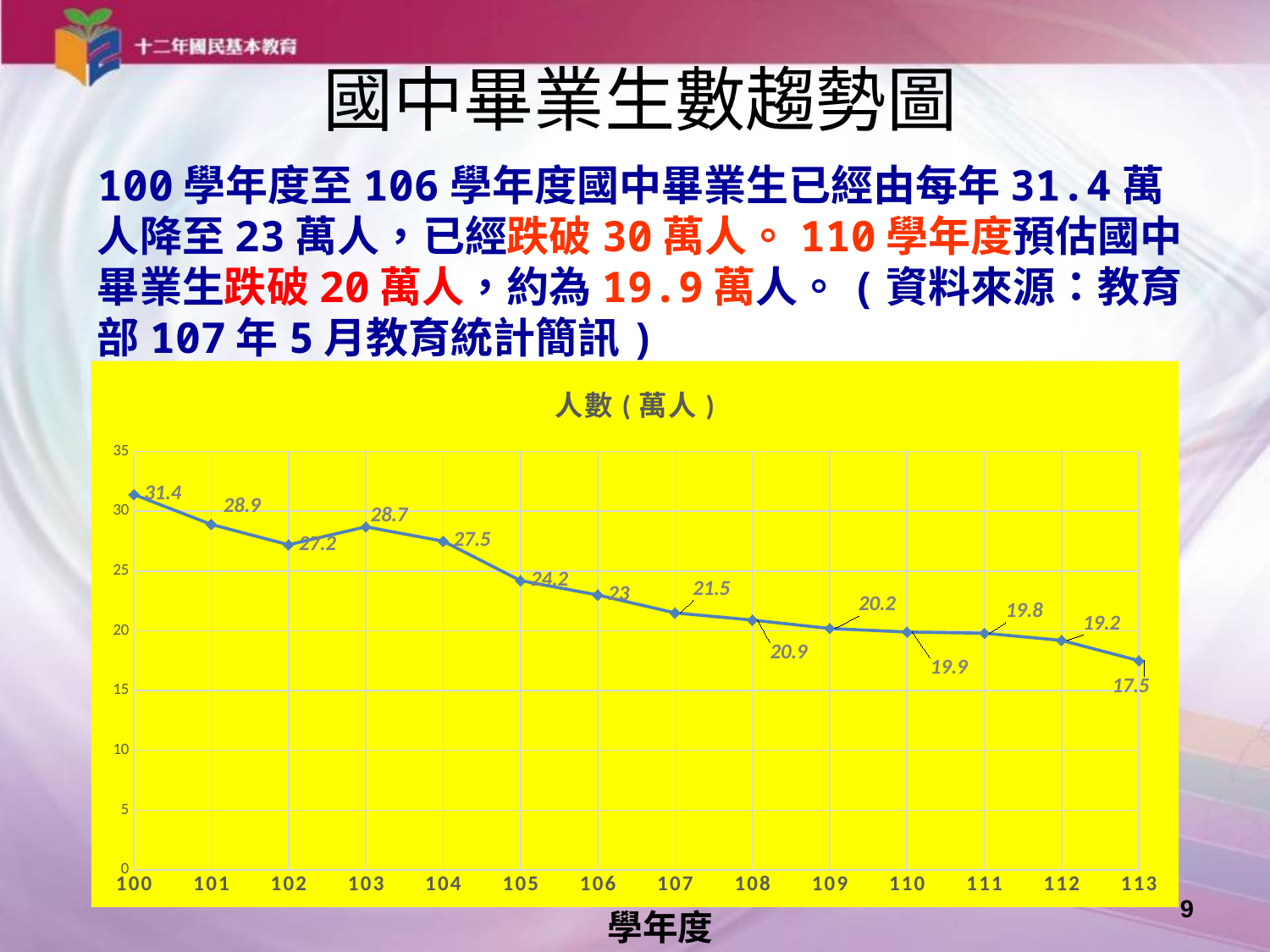
How many data points are plotted on the chart? 14 Which academic year has the highest value? 100 Which is larger, the value for academic year 102 or academic year 103? 103 Do the values generally rise or fall from academic year 100 to 113? fall What is the title of the chart? 人數（萬人） Which academic year has the lowest value? 113 What is the difference between the values for academic years 100 and 106? 8.4 What is the value for academic year 110? 19.9 What is the value for academic year 100? 31.4 What type of chart is shown on the slide? line chart What is the value for academic year 113? 17.5 What is the value for academic year 106? 23